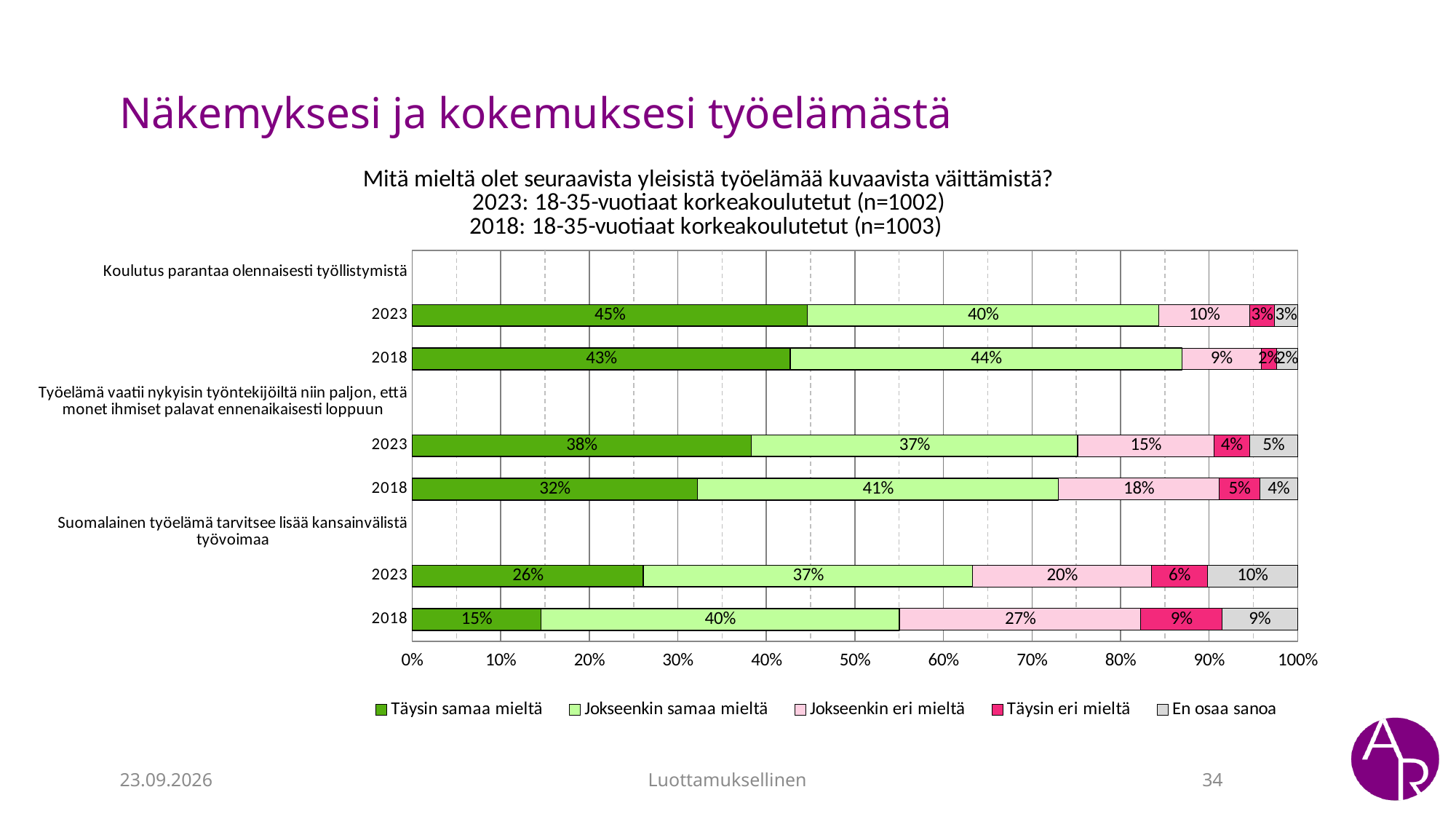
Which bar has the lowest 'Täysin samaa mieltä' share? Suomalainen työelämä tarvitsee lisää kansainvälistä työvoimaa, 2018 Is the 'Täysin samaa mieltä' share for 'Koulutus parantaa olennaisesti työllistymistä' in 2018 greater or less than 40%? greater Which legend entry is shown in dark green? Täysin samaa mieltä What is the 'Jokseenkin eri mieltä' share for the 2018 bar of 'Suomalainen työelämä tarvitsee lisää kansainvälistä työvoimaa'? 27% For the statement 'Työelämä vaatii nykyisin työntekijöiltä niin paljon, että monet ihmiset palavat ennenaikaisesti loppuun', which year has the larger 'Jokseenkin samaa mieltä' share, 2023 or 2018? 2018 By how many percentage points did the 'Täysin samaa mieltä' share for 'Suomalainen työelämä tarvitsee lisää kansainvälistä työvoimaa' change from 2018 to 2023? 11 percentage points Which bar has the highest 'Täysin samaa mieltä' share? Koulutus parantaa olennaisesti työllistymistä, 2023 What percentage of respondents in 2023 answered 'Täysin samaa mieltä' to the statement 'Koulutus parantaa olennaisesti työllistymistä'? 45% How many bars are plotted in the chart? 6 How many series does the legend list? 5 What is the 'En osaa sanoa' share for the 2023 bar of 'Suomalainen työelämä tarvitsee lisää kansainvälistä työvoimaa'? 10% What kind of chart is shown on the slide? Stacked bar chart